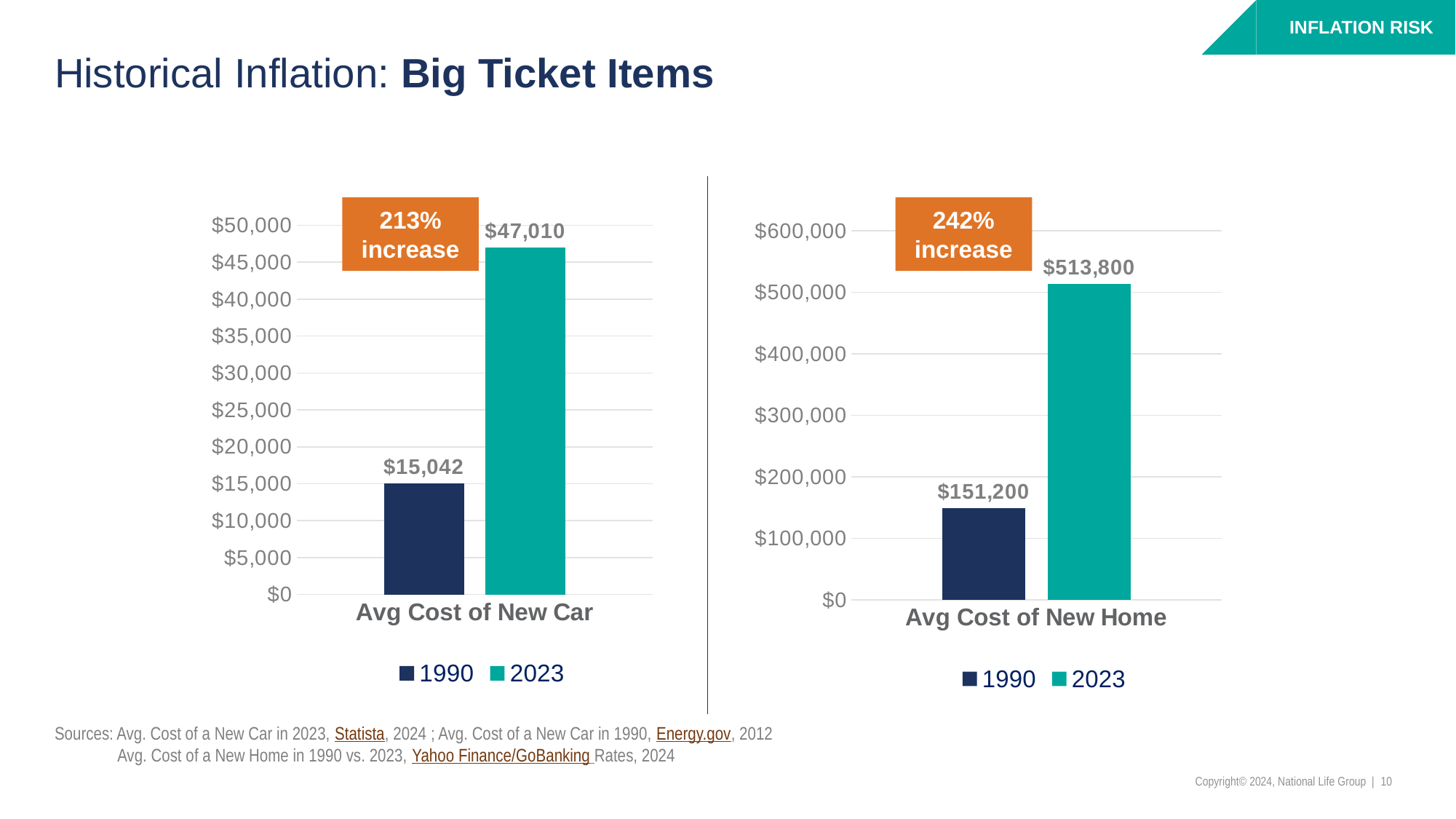
In the Avg Cost of New Home chart, what is the value for 1990? $151,200 In the Avg Cost of New Car chart, is the value for 1990 greater or less than $20,000? less What percentage increase is shown in the orange box on the Avg Cost of New Home chart? 242% increase How many series does the legend of the Avg Cost of New Car chart list? 2 In the Avg Cost of New Home chart, is the value for 2023 greater or less than $500,000? greater In the Avg Cost of New Car chart, what is the value for 2023? $47,010 In the Avg Cost of New Home chart, which series has the larger value, 1990 or 2023? 2023 What kind of chart is the Avg Cost of New Home chart? bar chart In the Avg Cost of New Home chart, what is the value for 2023? $513,800 In the Avg Cost of New Home chart, what is the difference between the 2023 and 1990 values? $362,600 In the Avg Cost of New Car chart, what is the value for 1990? $15,042 In the Avg Cost of New Car chart, what is the difference between the 2023 and 1990 values? $31,968